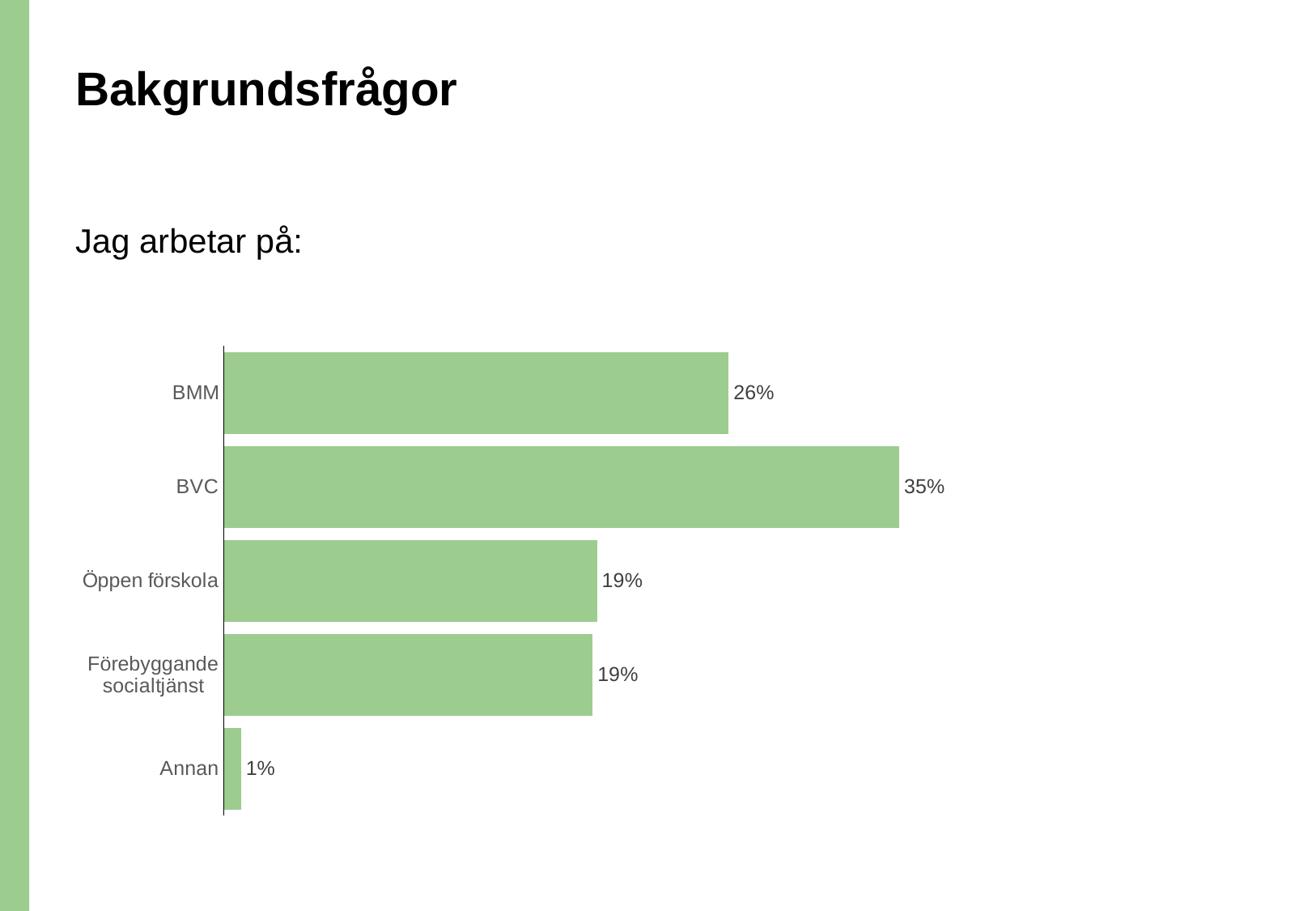
What is the difference between the values for BVC and BMM? 9% What kind of chart is shown on the slide? Bar chart Which is larger, the value for BMM or the value for Öppen förskola? BMM What is the value for Öppen förskola? 19% What is the value for BMM? 26% What is the value for BVC? 35% What is the difference between the values for BMM and Förebyggande socialtjänst? 7% Which category has the lowest value? Annan What question does the chart answer, as stated above it? Jag arbetar på: What is the value for Annan? 1% How many categories are shown in the chart? 5 Which category has the highest value? BVC